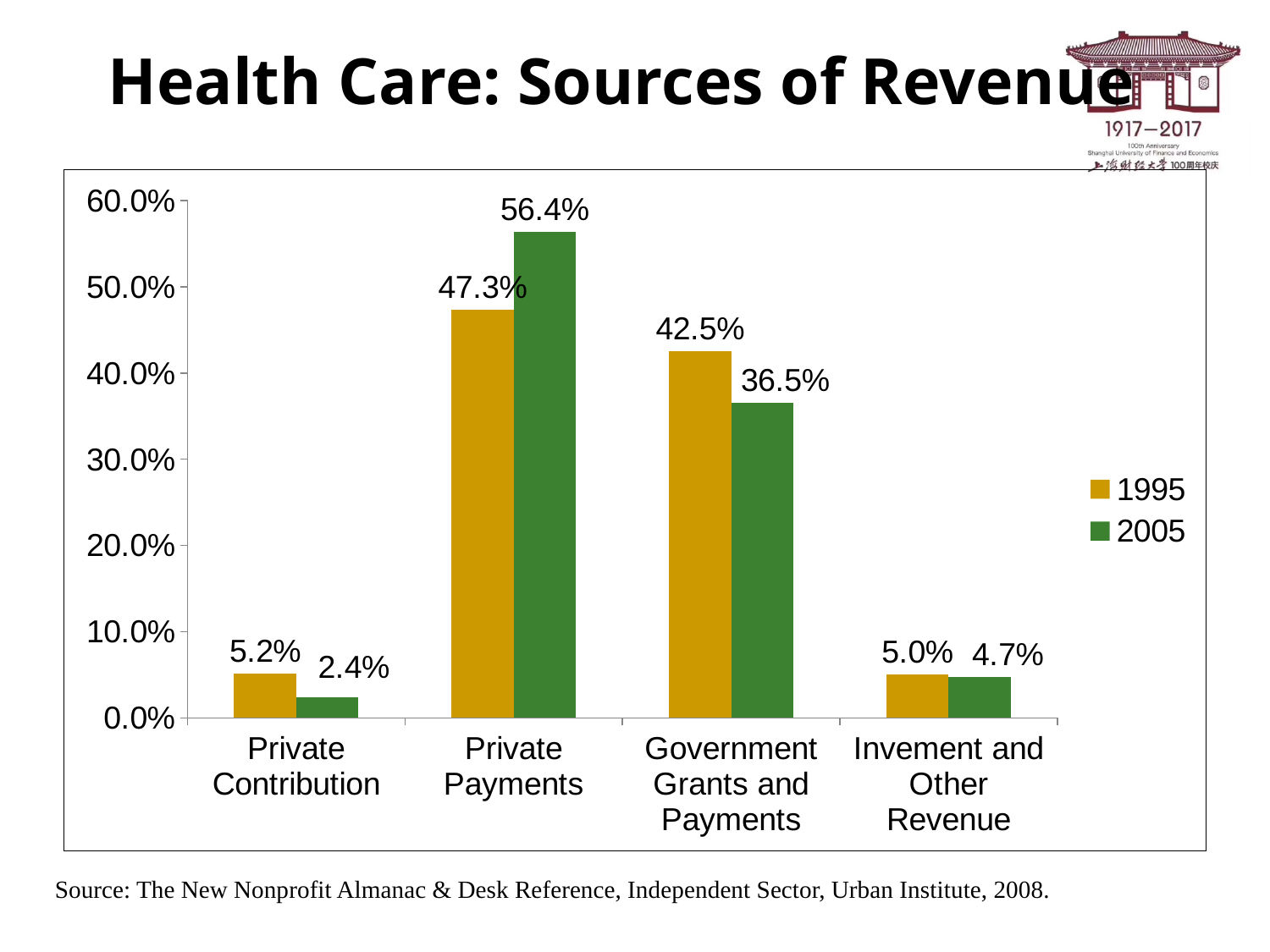
How many categories are shown on the x axis? 4 Which category has the lowest value in 1995? Invement and Other Revenue What is the value for Private Payments in 2005? 56.4% What is the difference between the 2005 and 1995 values for Private Payments? 9.1% What is the title of the slide? Health Care: Sources of Revenue What is the value for Private Contribution in 2005? 2.4% What is the value for Government Grants and Payments in 1995? 42.5% Is the 1995 value for Private Payments greater or less than 50.0%? less What kind of chart is shown on the slide? bar chart Which is larger for Government Grants and Payments, the 1995 value or the 2005 value? 1995 Which category has the highest value in 2005? Private Payments How many series does the legend list? 2